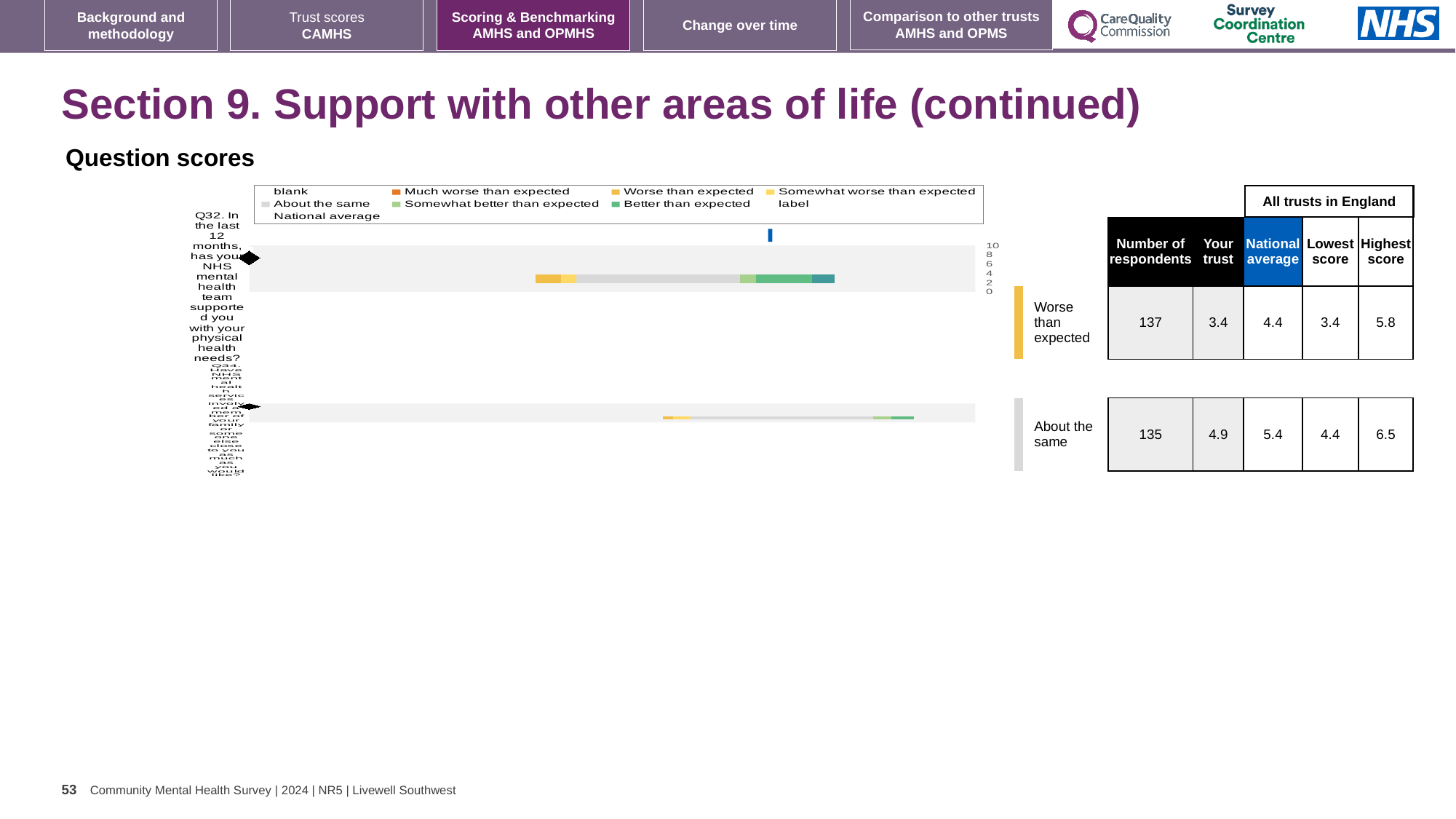
What is the national average score for Q34 (involving family or someone close)? 5.4 How many respondents answered Q32? 137 What is the difference between the highest score and the lowest score for Q34? 2.1 How many survey questions are plotted in the question scores chart? 2 What kind of chart is used to show the question scores on this slide? bar chart What is the 'Your trust' score for Q32 (support with physical health needs)? 3.4 Which benchmark category is Q32 placed in? Worse than expected For Q32, which is larger: the 'Your trust' score or the national average? National average Which of the two plotted questions has the higher 'Your trust' score? Q34 What is the difference between the national average and the 'Your trust' score for Q32? 1.0 What is the lowest score across all trusts in England for Q34? 4.4 What is the maximum value shown on the chart's score axis? 10